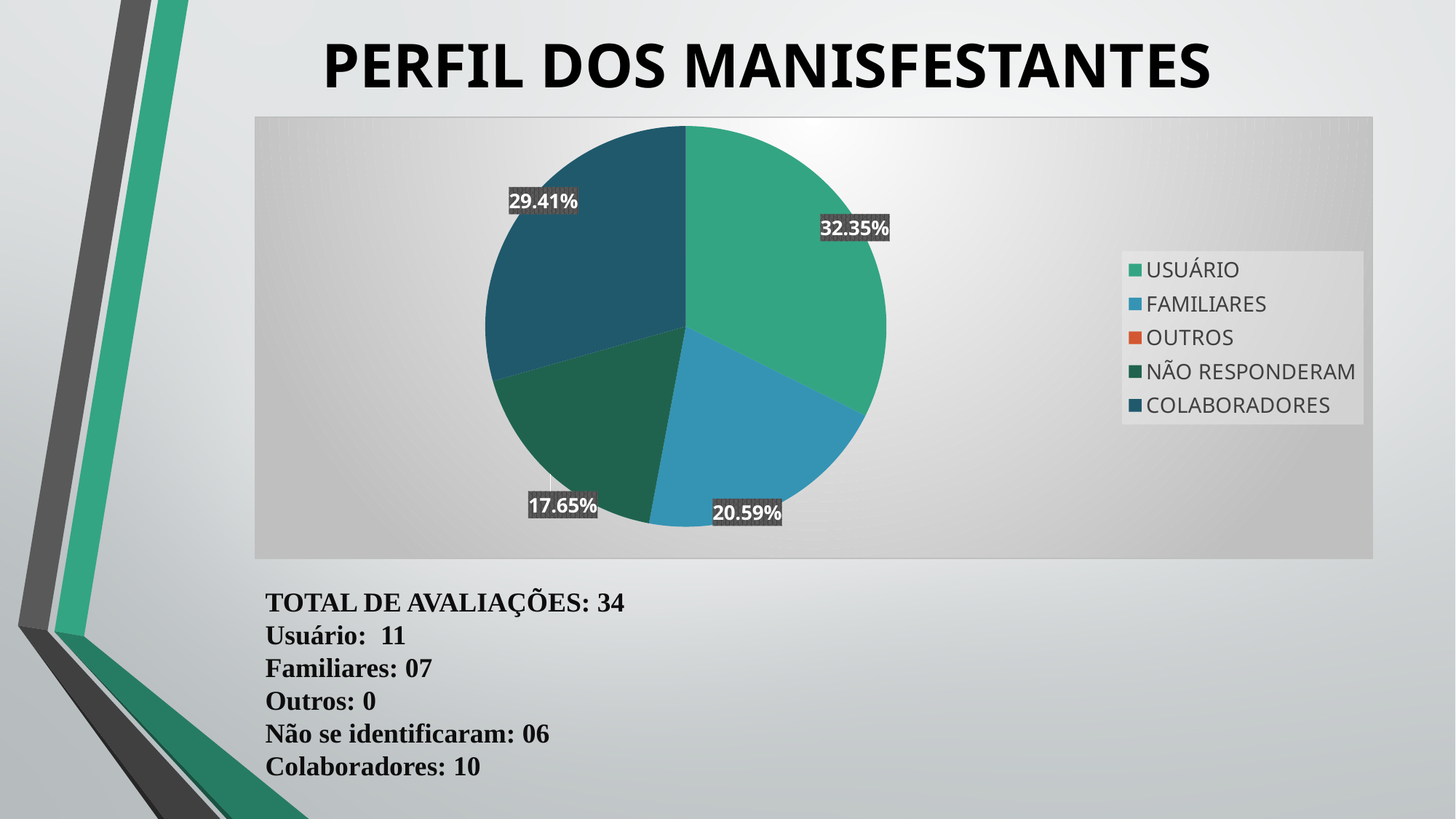
What percentage is shown for the COLABORADORES slice? 29.41% Which legend entry is shown in orange? OUTROS What percentage is shown for the NÃO RESPONDERAM slice? 17.65% What kind of chart is shown on the slide? pie chart How many entries does the legend list? 5 What is the difference in percentage points between the USUÁRIO and COLABORADORES slices? 2.94 Which category has the largest slice of the pie? USUÁRIO What percentage of the pie does the USUÁRIO slice represent? 32.35% Which category with a visible slice has the smallest share of the pie? NÃO RESPONDERAM What percentage is shown for the FAMILIARES slice? 20.59% Which slice is larger, FAMILIARES or COLABORADORES? COLABORADORES How many slices with data labels are visible in the pie? 4